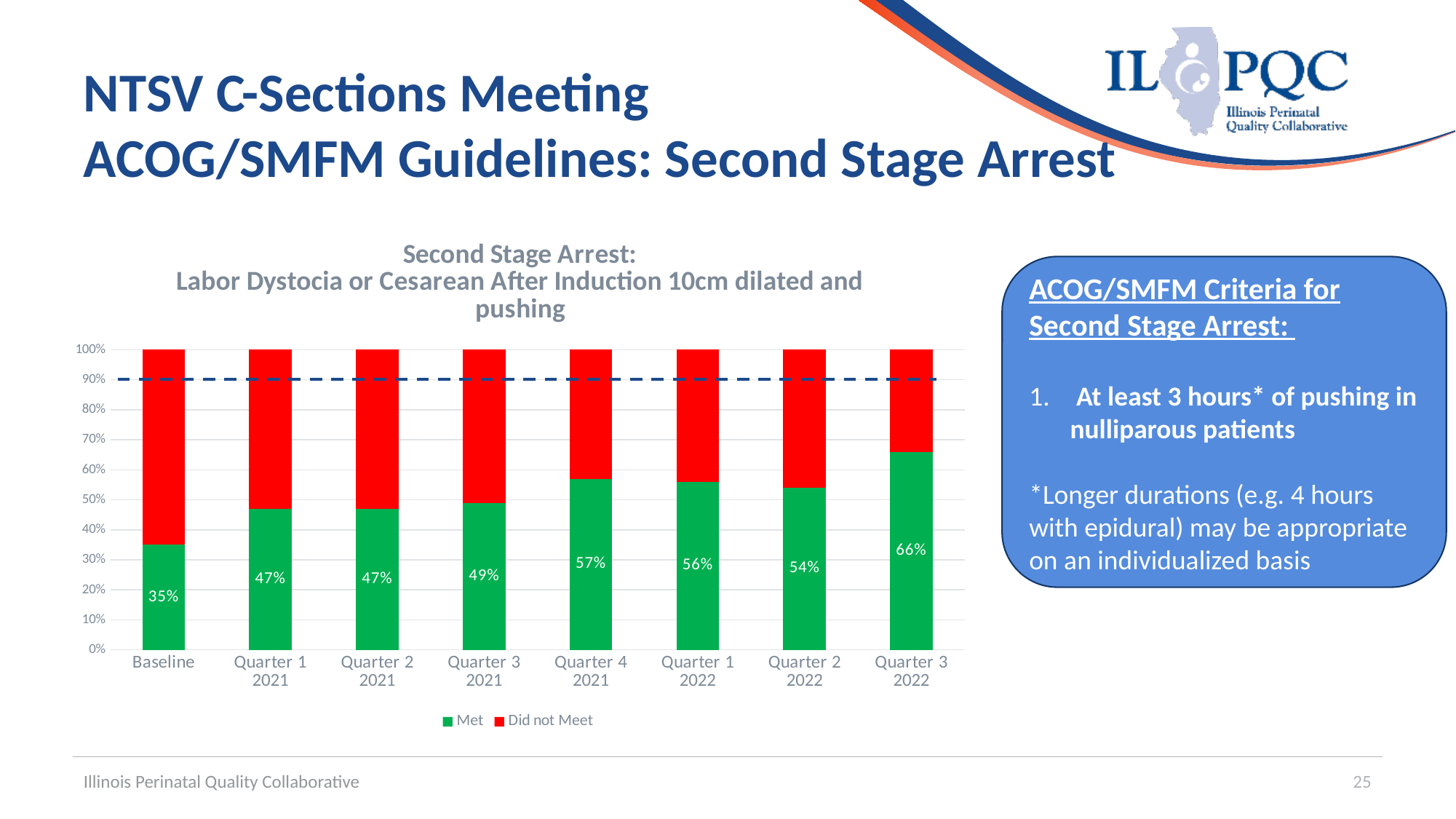
What is the Met value for Quarter 3 2022? 66% How many series does the legend list? 2 What is the difference in the Met percentage between Quarter 3 2022 and Baseline? 31% How many periods (bars) are shown on the x axis? 8 Which has a higher Met percentage, Quarter 1 2022 or Quarter 2 2022? Quarter 1 2022 Is the Did not Meet value for Baseline greater or less than 60%? greater Which period has the lowest Met percentage? Baseline What percentage of cases Met the criteria at Baseline? 35% What is the Met value for Quarter 4 2021? 57% What kind of chart is shown on the slide? Stacked bar chart Which period has the highest Met percentage? Quarter 3 2022 Which colour represents the Met series in the chart? Green